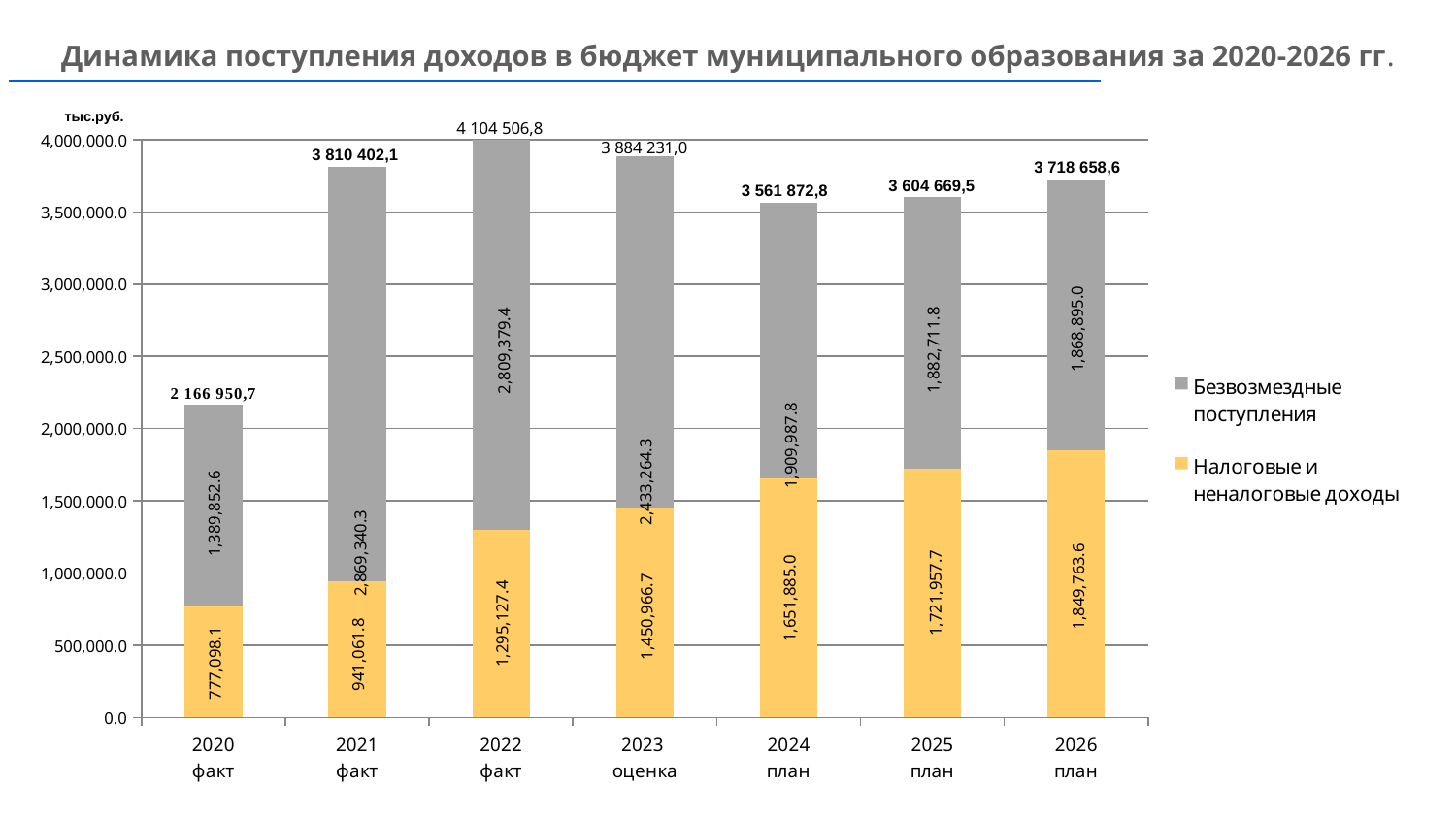
What unit is indicated above the vertical axis? тыс.руб. What is the value of Налоговые и неналоговые доходы for 2020 факт? 777,098.1 How many series does the legend list? 2 Do the values of Налоговые и неналоговые доходы rise or fall from 2020 to 2026? Rise How many year categories are shown on the x axis? 7 Which is larger in 2021 факт: Безвозмездные поступления or Налоговые и неналоговые доходы? Безвозмездные поступления Which year has the lowest total bar? 2020 факт What type of chart is shown on the slide? Stacked bar chart What is the total of the stacked bar for 2023 оценка? 3 884 231,0 Which year has the highest total bar? 2022 факт What is the value of Безвозмездные поступления for 2022 факт? 2,809,379.4 What is the difference between Безвозмездные поступления and Налоговые и неналоговые доходы in 2026 план? 19,131.4